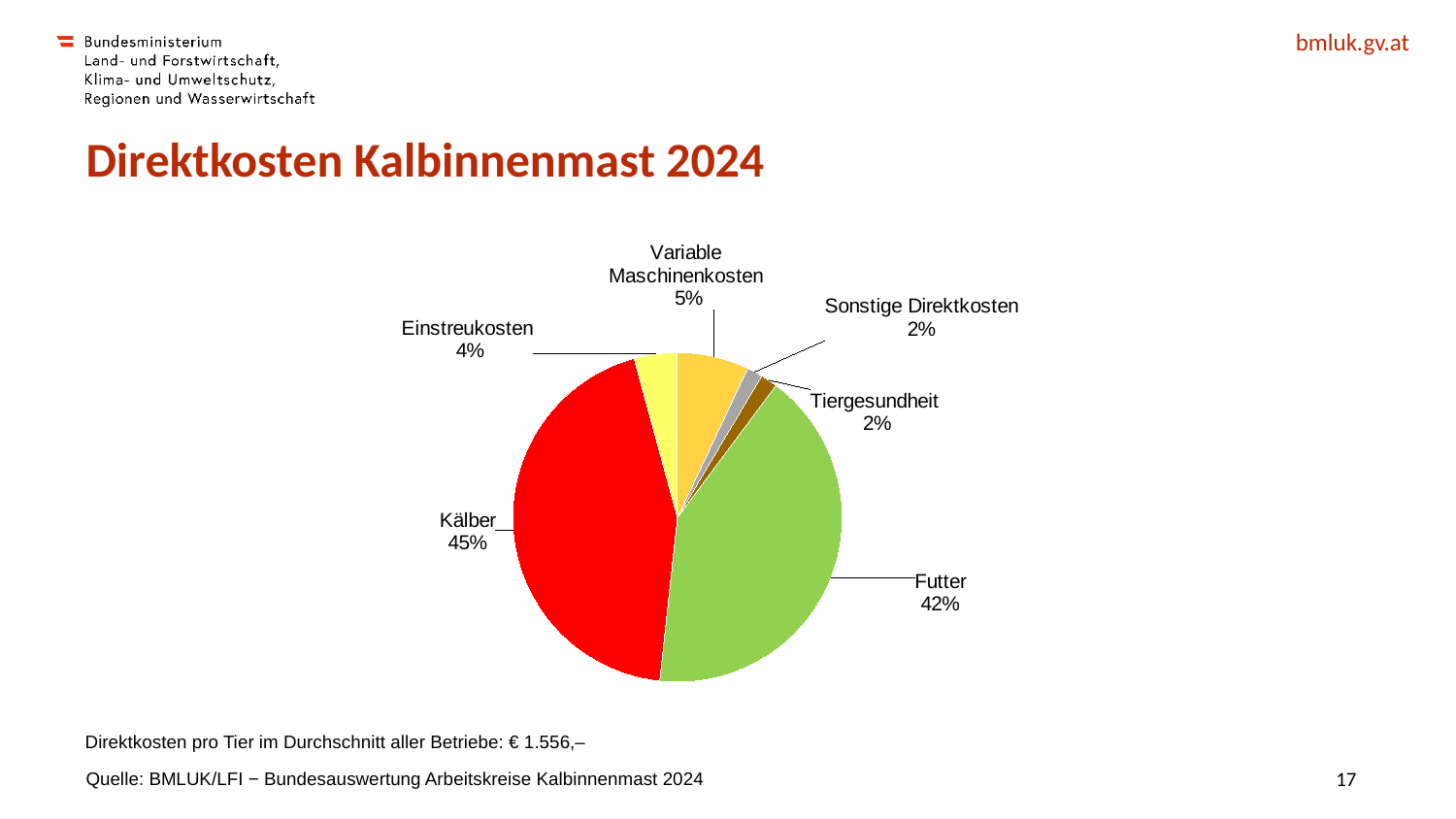
What share of the pie does Kälber account for? 45% Which is larger, Variable Maschinenkosten or Einstreukosten? Variable Maschinenkosten What is the value shown for Einstreukosten? 4% What type of chart is shown on the slide? pie chart How many slices does the pie chart have? 6 What is the title of the chart on the slide? Direktkosten Kalbinnenmast 2024 Which category has the largest slice of the pie? Kälber What is the value shown for Variable Maschinenkosten? 5% What is the difference in percentage points between Kälber and Futter? 3 What share of the pie does Futter account for? 42% What is the value shown for Tiergesundheit? 2% What colour is the Futter slice of the pie? green